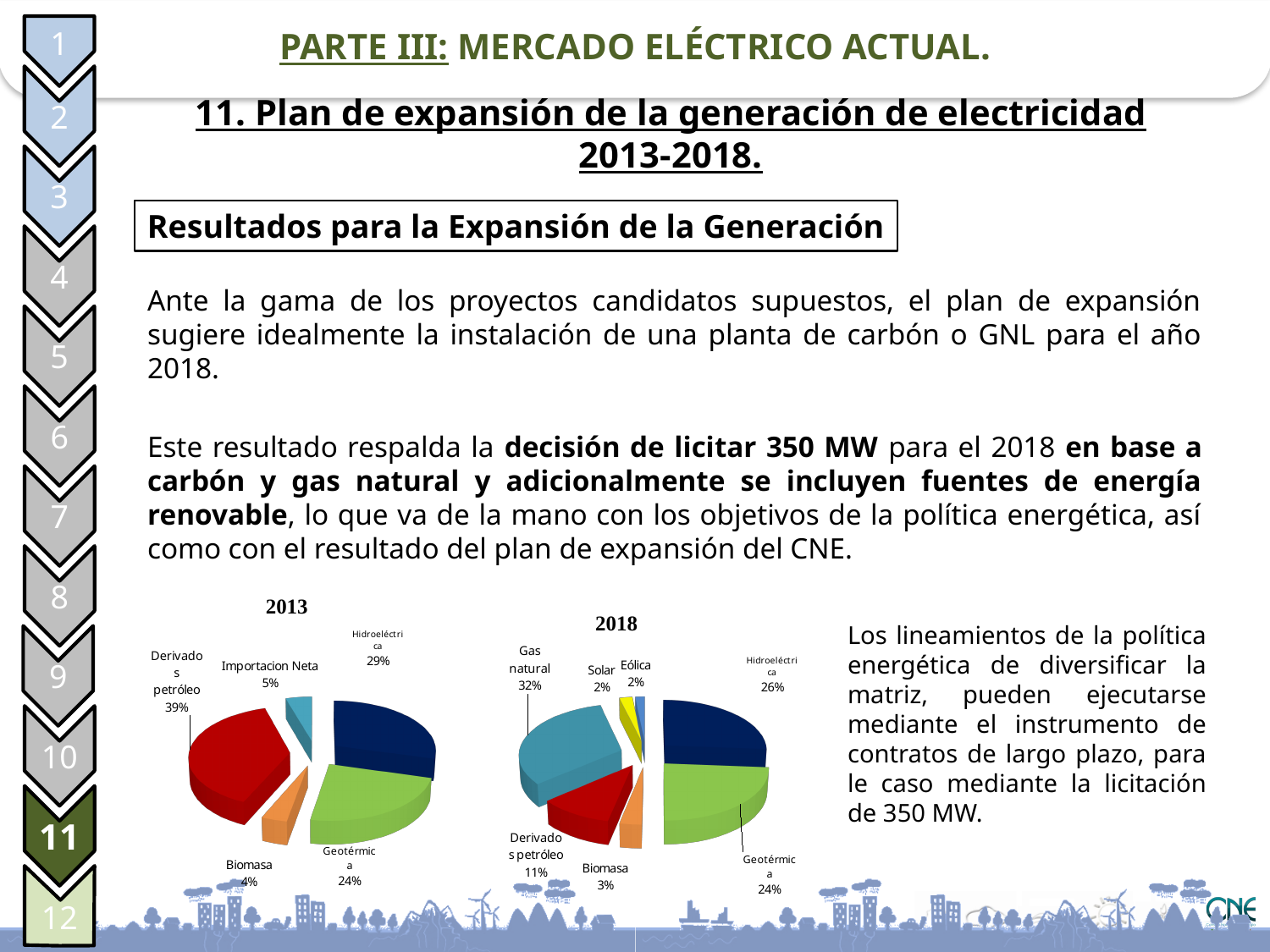
In the 2018 pie chart, what is the difference between the shares of Hidroeléctrica and Geotérmica? 2% In the 2013 pie chart, what share does Hidroeléctrica have? 29% In the 2018 pie chart, what share does Derivados petróleo have? 11% In the 2018 pie chart, how many categories are shown? 7 In the 2018 pie chart, what share does Gas natural have? 32% In the 2013 pie chart, what share does Derivados petróleo have? 39% What type of chart is used for the 2013 and 2018 data? Pie chart In the 2013 pie chart, how many categories are shown? 5 Which is larger: the share of Derivados petróleo in the 2013 chart or in the 2018 chart? 2013 In the 2013 pie chart, which category has the largest share? Derivados petróleo In the 2013 pie chart, which category has the smallest share? Biomasa In the 2018 pie chart, which category has the largest share? Gas natural